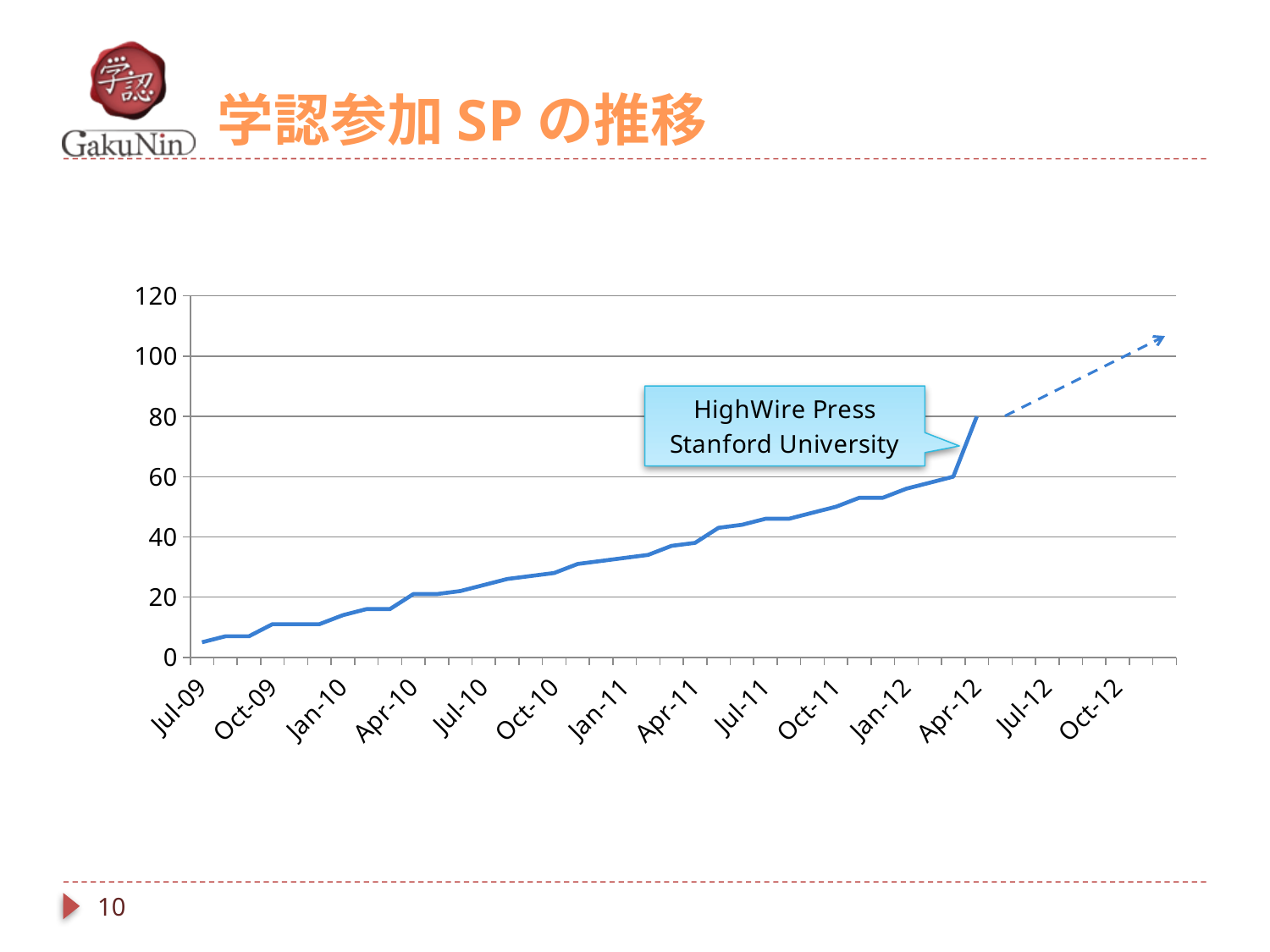
Which is larger, the value for Apr-12 or the value for Jan-12? Apr-12 What text is shown in the callout box pointing at the jump in the line? HighWire Press Stanford University Do the values in the chart rise or fall from Jul-09 to Apr-12? rise What is the highest tick value shown on the y axis? 120 What kind of chart is shown on the slide? line chart Which labelled date on the x axis has the lowest value on the solid line? Jul-09 How many date labels are shown on the x axis? 14 Is the value for Apr-12 greater or less than 60? greater Is the value for Oct-10 greater or less than 40? less Is the value for Jul-09 greater or less than 20? less